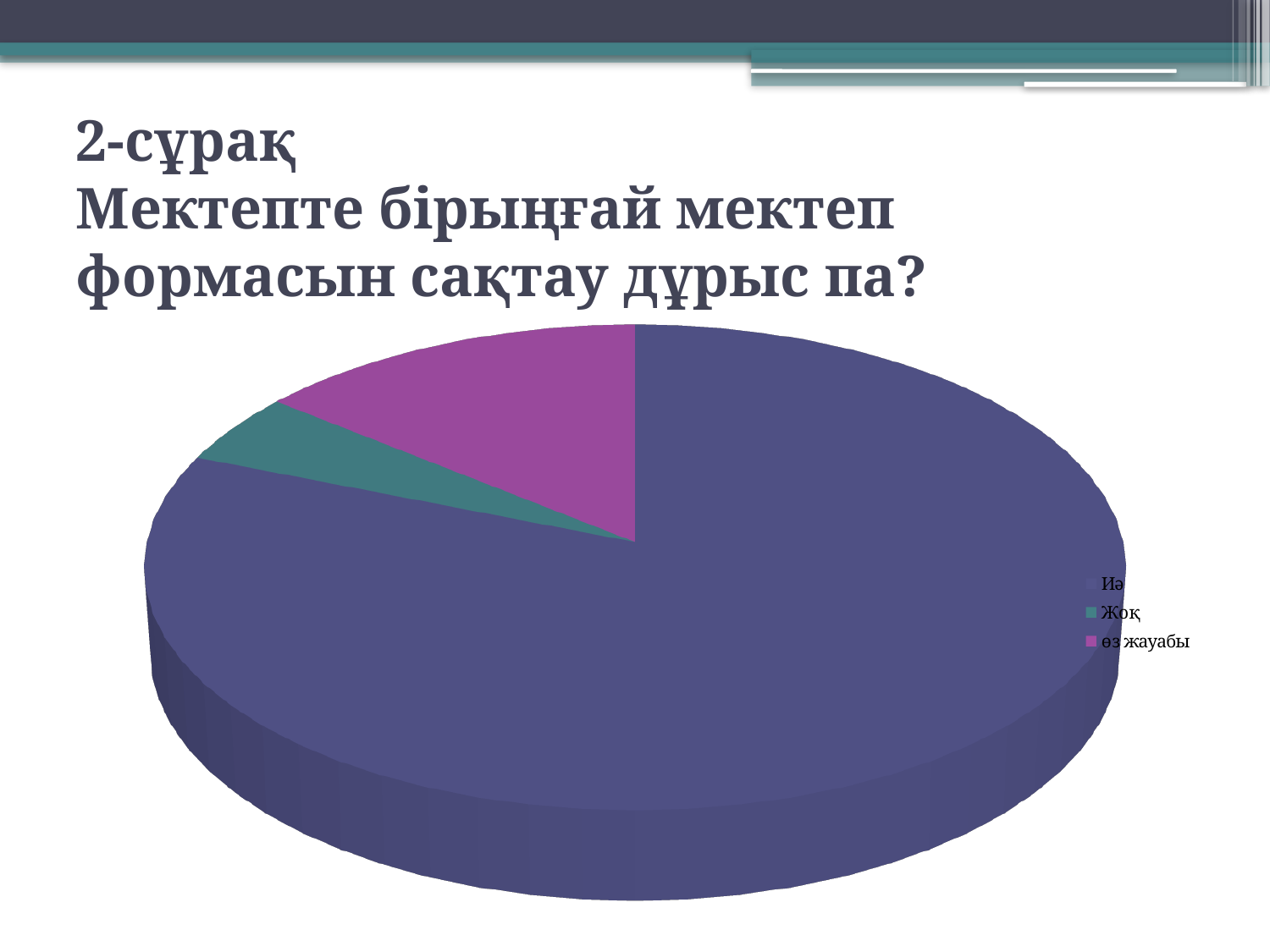
What kind of chart is shown on the slide? pie chart Which legend entry is shown in teal/green in the pie chart? Жоқ How many entries does the legend of the pie chart list? 3 Which slice is larger, Жоқ or өз жауабы? өз жауабы Which slice is larger, Иә or өз жауабы? Иә Which category has the largest slice of the pie chart? Иә Which slice is smaller, Иә or Жоқ? Жоқ How many slices does the pie chart have? 3 Which category has the smallest slice of the pie chart? Жоқ What question does the slide title say the pie chart is about? Мектепте бірыңғай мектеп формасын сақтау дұрыс па?